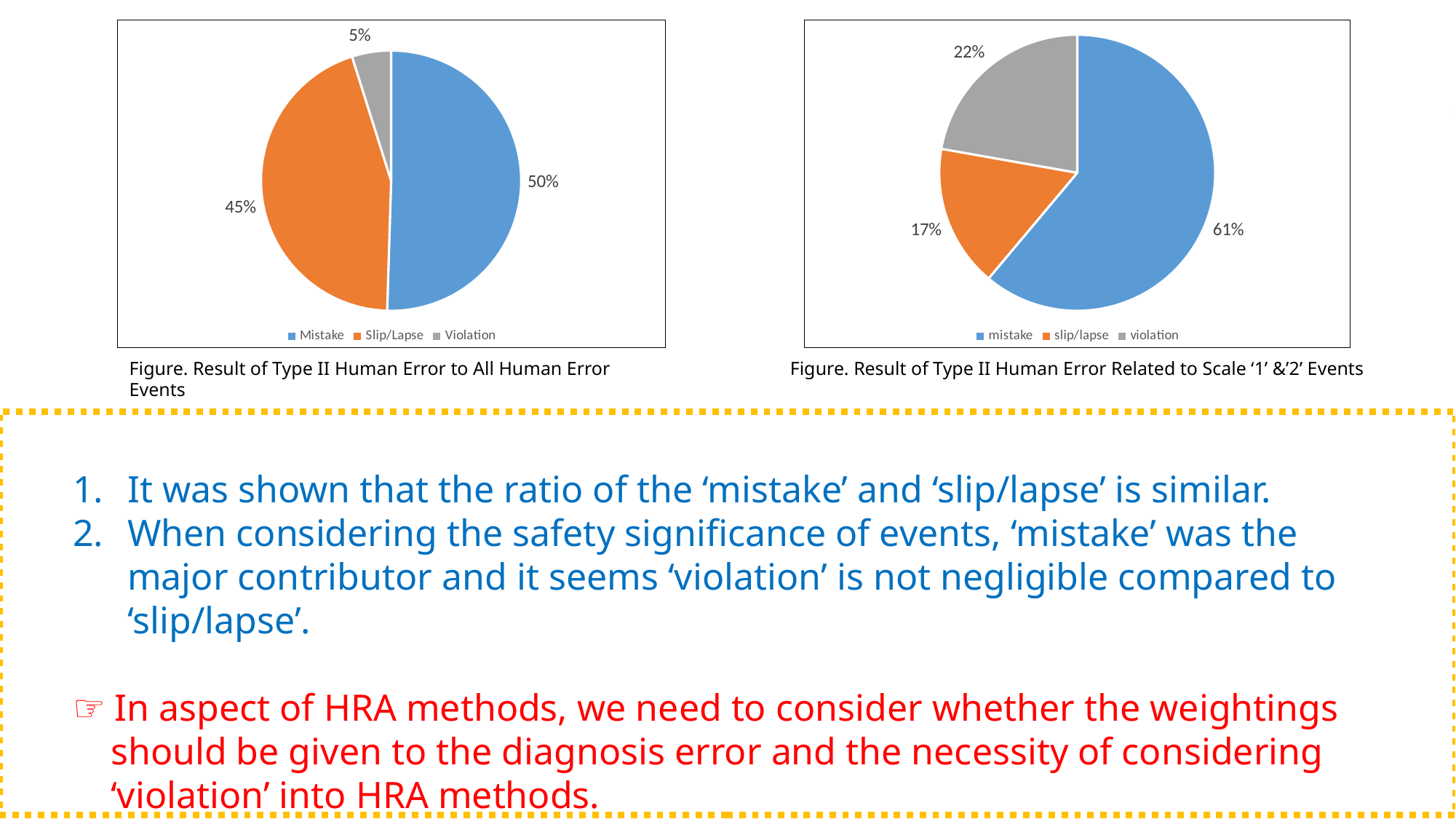
In the left pie chart (Type II Human Error to All Human Error Events), what share is labelled for Violation? 5% In the right pie chart (Type II Human Error Related to Scale '1' & '2' Events), which category has the smallest slice? slip/lapse In the left pie chart (Type II Human Error to All Human Error Events), which is larger, Slip/Lapse or Violation? Slip/Lapse In the right pie chart (Type II Human Error Related to Scale '1' & '2' Events), what is the difference in percentage points between mistake and violation? 39 What type of chart is the left chart (Type II Human Error to All Human Error Events)? Pie chart In the right pie chart (Type II Human Error Related to Scale '1' & '2' Events), what share is labelled for violation? 22% In the left pie chart (Type II Human Error to All Human Error Events), which category has the smallest slice? Violation In the left pie chart (Type II Human Error to All Human Error Events), what share is labelled for Mistake? 50% In the right pie chart (Type II Human Error Related to Scale '1' & '2' Events), which category has the largest slice? mistake In the right pie chart (Type II Human Error Related to Scale '1' & '2' Events), what share is labelled for mistake? 61% In the left pie chart (Type II Human Error to All Human Error Events), what share is labelled for Slip/Lapse? 45% How many categories does the legend of the right pie chart (Type II Human Error Related to Scale '1' & '2' Events) list? 3